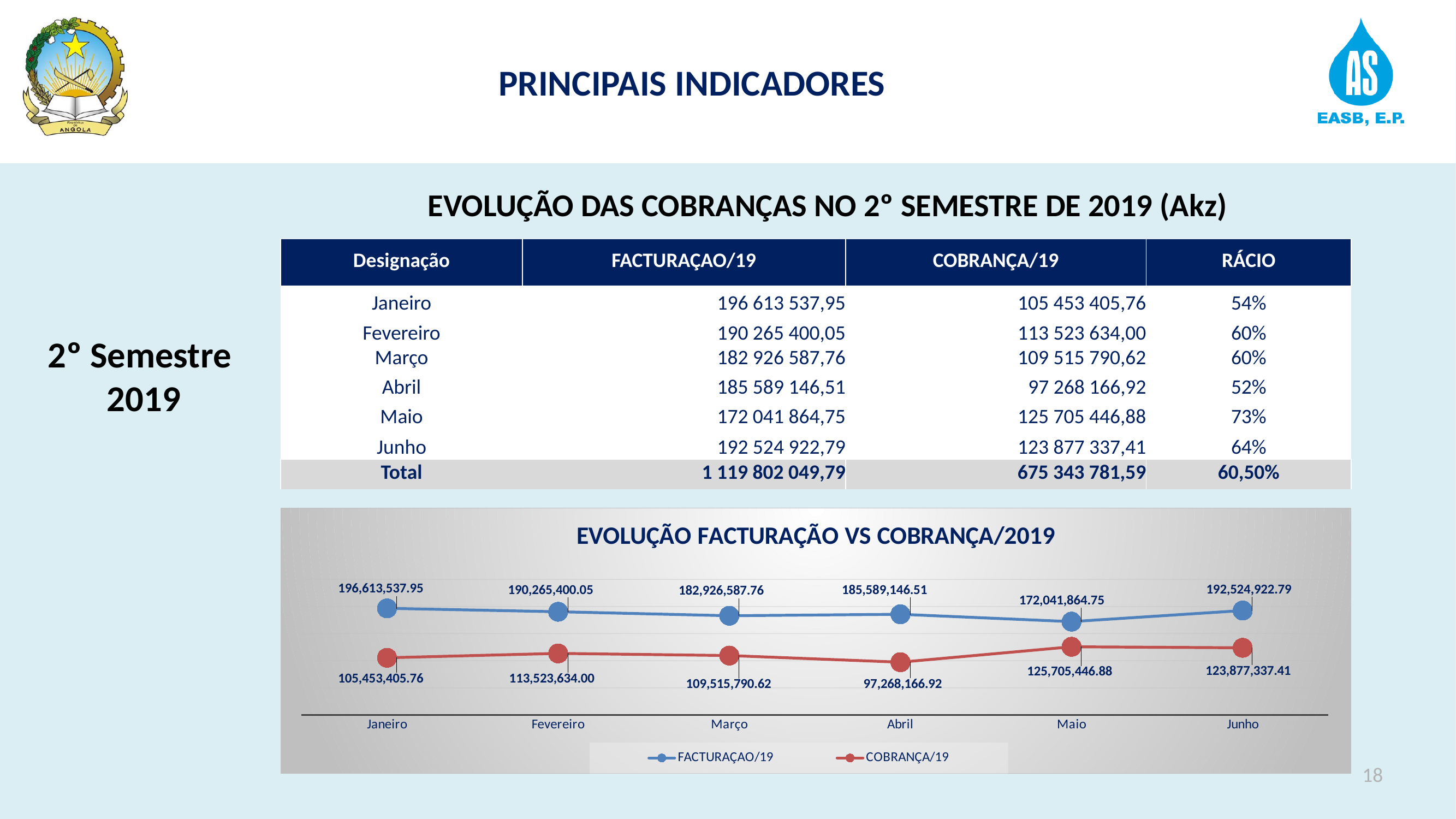
What type of chart is shown under the title EVOLUÇÃO FACTURAÇÃO VS COBRANÇA/2019? Line chart How many months are plotted along the x axis of the chart? 6 Which month has the lowest FACTURAÇAO/19 value in the chart? Maio Which month has the highest COBRANÇA/19 value in the chart? Maio What is the FACTURAÇAO/19 value for Janeiro in the chart? 196,613,537.95 Which month has the highest FACTURAÇAO/19 value in the chart? Janeiro Which month has the lowest COBRANÇA/19 value in the chart? Abril Which series is drawn in red in the chart? COBRANÇA/19 What is the COBRANÇA/19 value for Junho in the chart? 123,877,337.41 How many series does the legend of the chart list? 2 What is the difference between the FACTURAÇAO/19 and COBRANÇA/19 values for Janeiro in the chart? 91,160,132.19 What is the COBRANÇA/19 value for Abril in the chart? 97,268,166.92